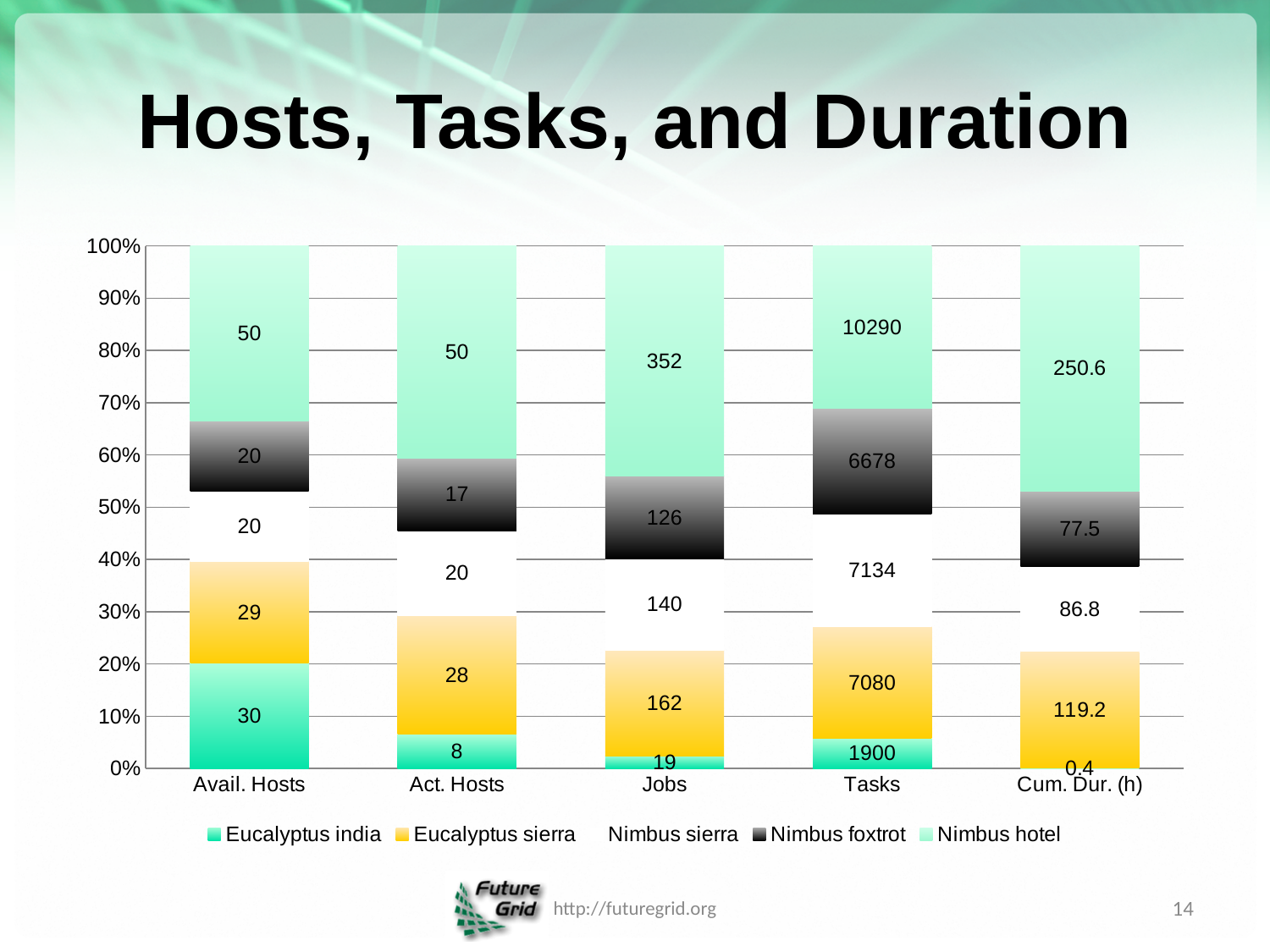
What is the value for Eucalyptus india in the Cum. Dur. (h) category? 0.4 What kind of chart is shown on the slide? 100% stacked bar chart What is the title of the slide? Hosts, Tasks, and Duration What is the value for Nimbus foxtrot in the Jobs category? 126 Which series has the lowest value in the Jobs category? Eucalyptus india How many series does the legend list? 5 What is the difference between the Nimbus hotel and Nimbus sierra values in the Jobs category? 212 Which series has the highest value in the Act. Hosts category? Nimbus hotel How many categories are shown on the x axis? 5 What is the value for Nimbus hotel in the Tasks category? 10290 What is the total of all series in the Act. Hosts bar? 123 In the Tasks category, which is larger: Eucalyptus sierra or Nimbus foxtrot? Eucalyptus sierra